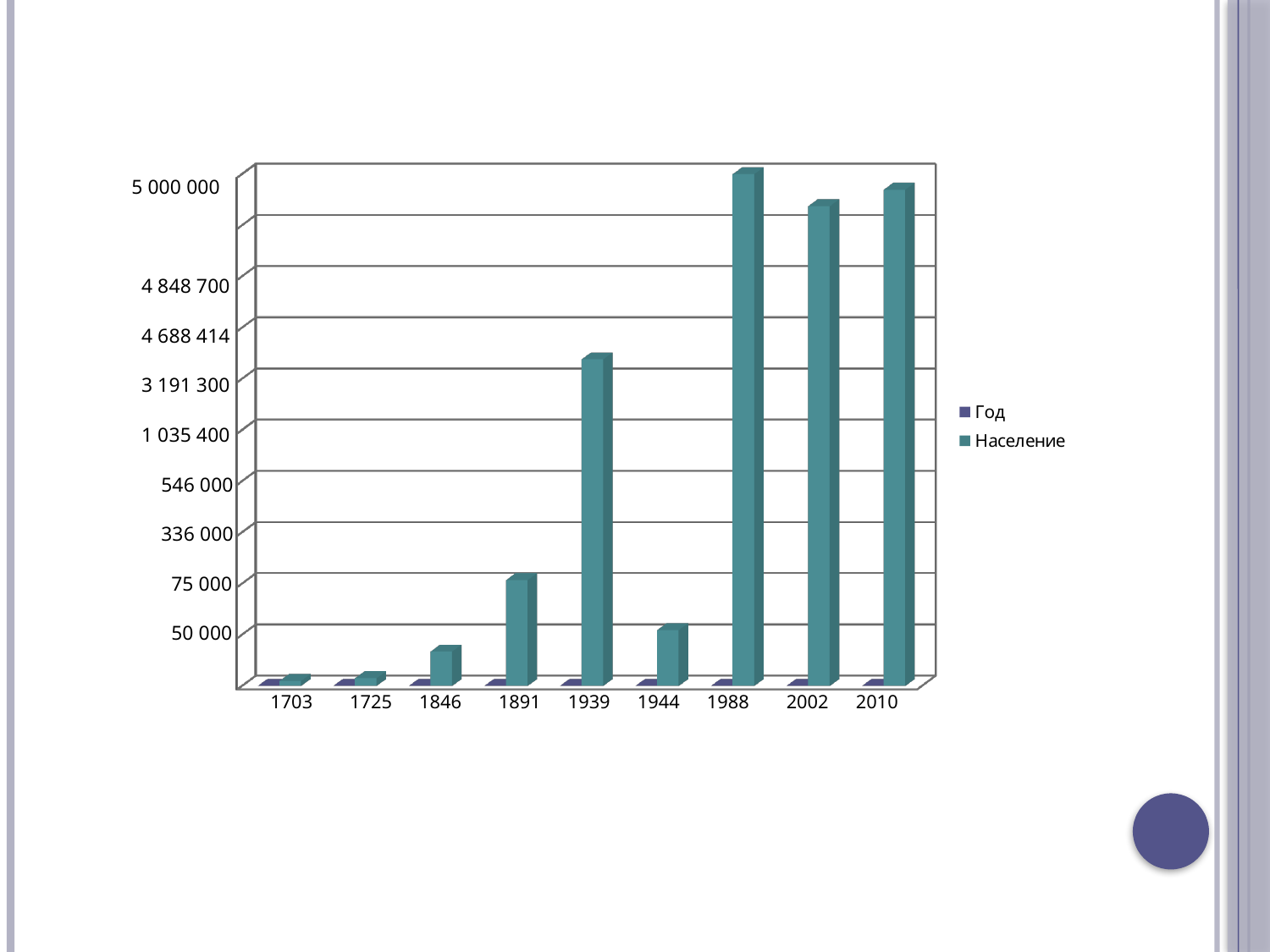
Which is larger, the Население bar for 1891 or for 1944? 1891 Is the Население value for 1939 greater or less than 1 035 400? greater What kind of chart is shown on the slide? bar chart How many series does the chart legend list? 2 What are the two entries listed in the chart legend? Год and Население How many years are shown along the x axis of the chart? 9 Which is larger, the Население bar for 1846 or for 1891? 1891 Which year has the tallest Население bar? 1988 Which is larger, the Население bar for 1939 or for 1944? 1939 What is the first year shown on the x axis of the chart? 1703 Is the Население value for 1988 greater or less than 3 191 300? greater